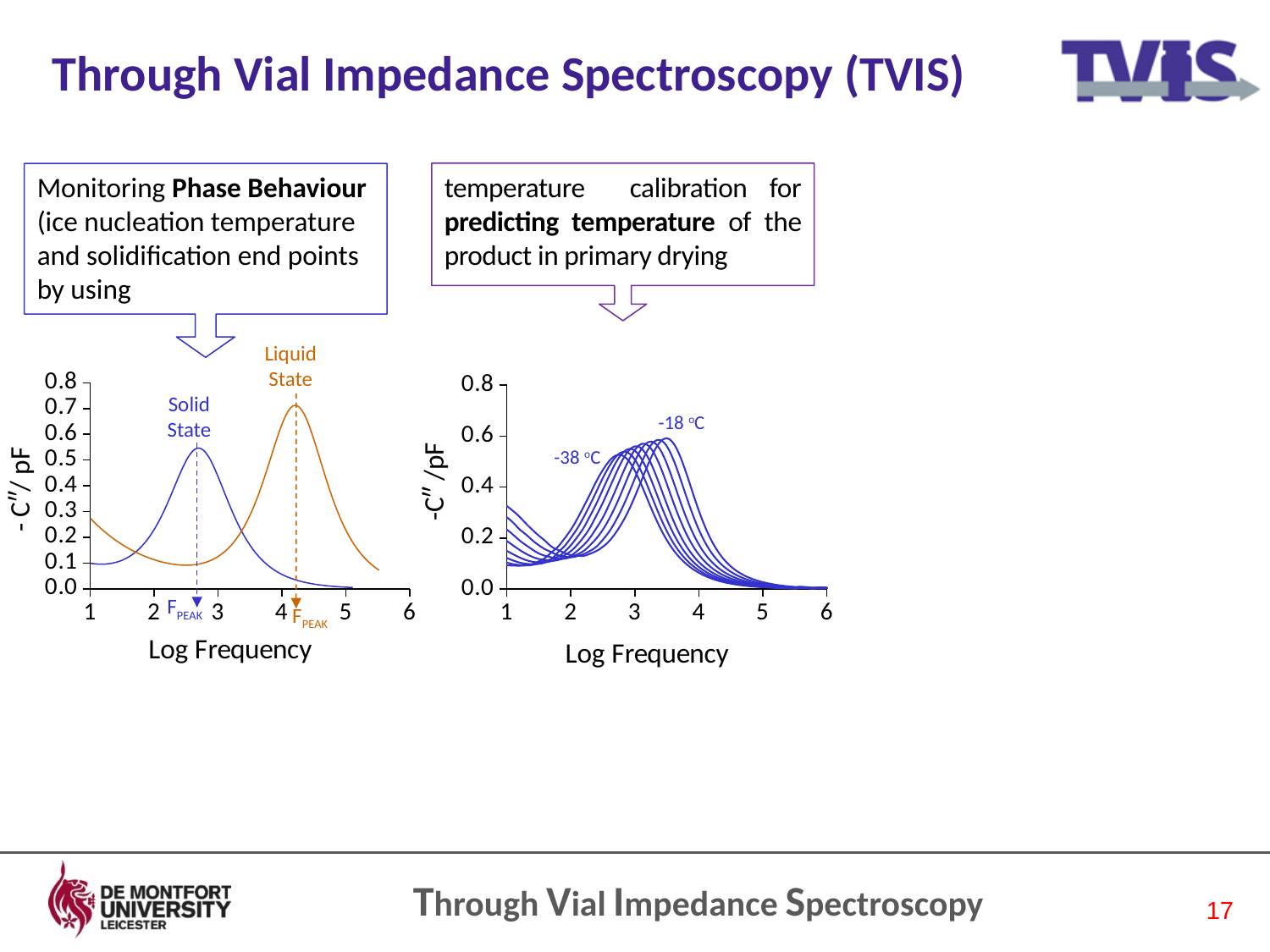
In the right chart, which curve peaks at the lower log frequency, -38 °C or -18 °C? -38 °C What is the x-axis label of the right chart? Log Frequency In the left chart, is the peak value of the Liquid State curve greater or less than 0.6? greater In the left chart, which curve has its peak at the higher log frequency, Solid State or Liquid State? Liquid State In the left chart, is the log frequency of the Solid State peak greater or less than 3? less What kind of chart is the left chart showing Solid State and Liquid State? line chart In the left chart, which curve reaches the higher peak, Solid State or Liquid State? Liquid State What kind of chart is the right chart with the -38 °C and -18 °C curves? line chart In the left chart, is the peak value of the Solid State curve greater or less than 0.7? less What are the two temperature labels shown on the right chart? -38 °C and -18 °C In the left chart, does the Solid State curve rise or fall as log frequency increases from 3 to 5? fall